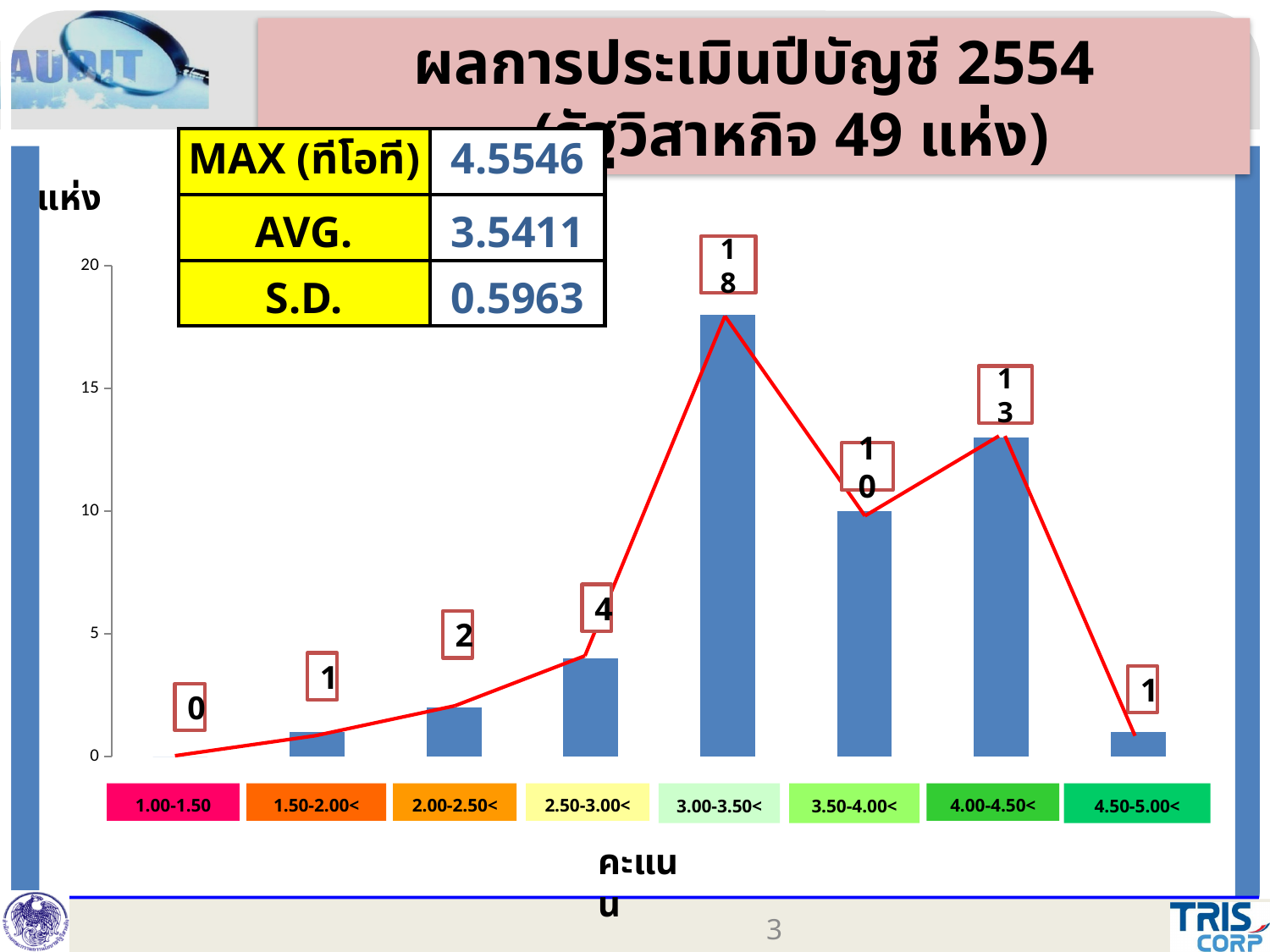
Which is larger, the value for 3.50-4.00< or the value for 4.00-4.50<? 4.00-4.50< What is the value shown for the 1.00-1.50 score range? 0 How many score ranges are shown on the x axis? 8 Which score range has the highest number of state enterprises? 3.00-3.50< Do the values rise or fall from the 2.00-2.50< range to the 3.00-3.50< range? Rise What is the AVG. value shown in the table on the slide? 3.5411 What is the value shown for the 4.00-4.50< score range? 13 Which score range has the lowest value? 1.00-1.50 What is the difference between the values for 3.00-3.50< and 3.50-4.00<? 8 What is the S.D. value shown in the table on the slide? 0.5963 How many state enterprises fall in the 3.00-3.50< score range? 18 What kind of chart is shown on the slide? Bar chart with a line overlay